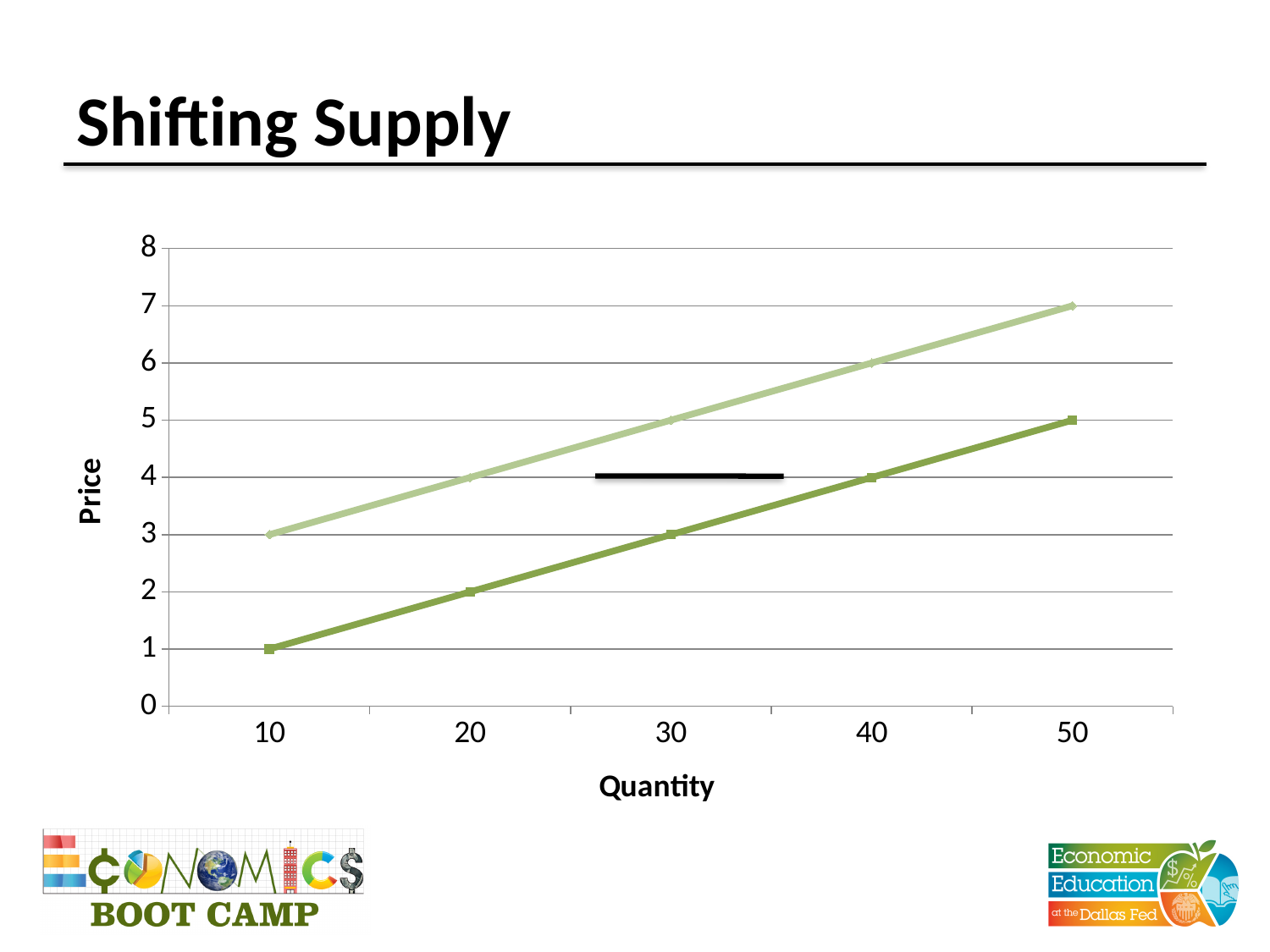
What is the price on the dark green line at a quantity of 30? 3 What is the price on the light green line at a quantity of 30? 5 What is the price on the light green line at a quantity of 10? 3 What is the label of the vertical axis? Price Which line shows the higher price at a quantity of 20, the light green line or the dark green line? light green line Do prices on the dark green line rise or fall as quantity increases? rise What is the difference in price between the light green line and the dark green line at a quantity of 40? 2 How many quantity values are plotted along the x axis? 5 What is the price on the dark green line at a quantity of 50? 5 At which quantity does the light green line reach its highest price? 50 What is the title of the chart on the slide? Shifting Supply What kind of chart is shown on the slide? line chart